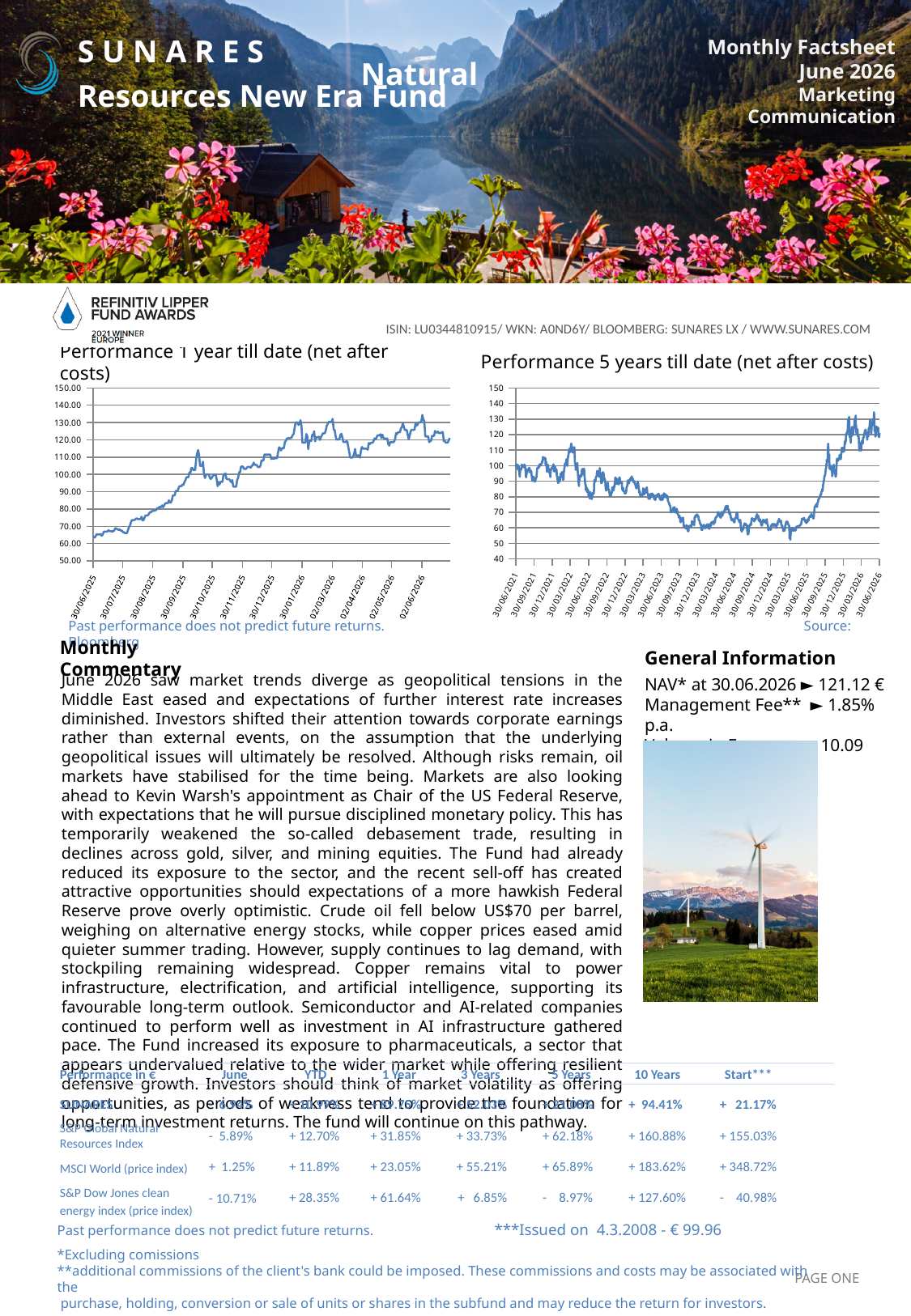
In the 'Performance 1 year till date (net after costs)' chart, do the values overall rise or fall from 30/06/2025 to 02/06/2026? rise What kind of chart is the 'Performance 5 years till date (net after costs)' chart? line chart In the 'Performance 5 years till date (net after costs)' chart, is the value at 30/06/2026 higher or lower than the value at 30/12/2023? higher How many lines are plotted in the 'Performance 1 year till date (net after costs)' chart? 1 In the 'Performance 1 year till date (net after costs)' chart, is the value at 30/06/2025 greater or less than 80.00? less What is the highest value shown on the y axis of the 'Performance 1 year till date (net after costs)' chart? 150.00 In the 'Performance 5 years till date (net after costs)' chart, is the value at 30/12/2023 greater or less than 80? less What kind of chart is the 'Performance 1 year till date (net after costs)' chart? line chart What is the lowest value shown on the y axis of the 'Performance 5 years till date (net after costs)' chart? 40 In the 'Performance 5 years till date (net after costs)' chart, is the value at 30/06/2026 greater or less than 100? greater